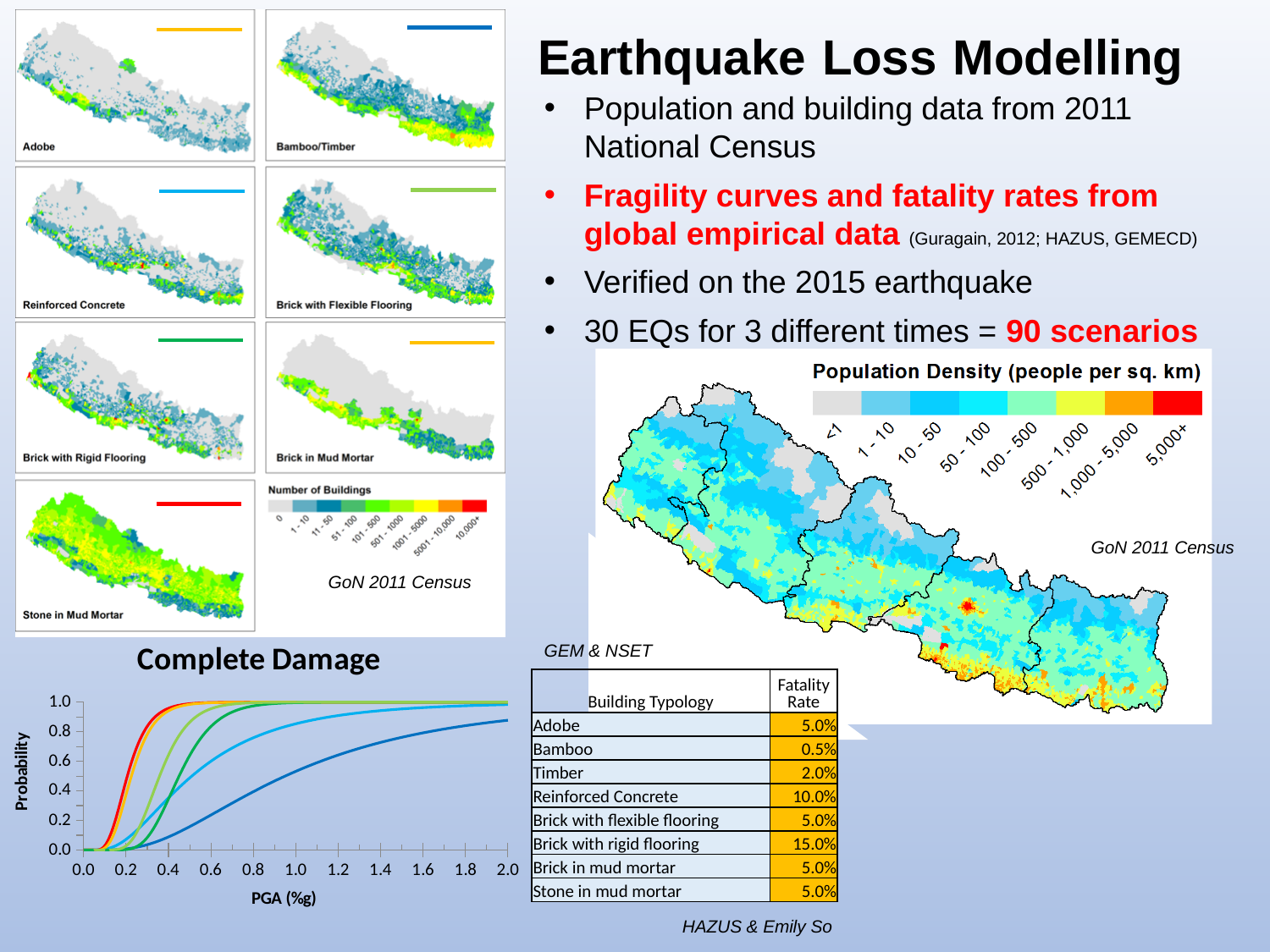
In the 'Complete Damage' chart, is the value of the red curve at PGA 0.4 greater or less than 0.8? greater In the 'Complete Damage' chart, which curve reaches a probability of 1.0 at the lowest PGA? red curve What is the x-axis label of the 'Complete Damage' chart? PGA (%g) What is the title of the line chart at the bottom left of the slide? Complete Damage What kind of chart is the 'Complete Damage' chart? line chart In the 'Complete Damage' chart, do the curves rise or fall as PGA increases? rise What is the maximum value shown on the x axis of the 'Complete Damage' chart? 2.0 In the 'Complete Damage' chart, which curve has the lowest probability at PGA 1.0? dark blue curve In the 'Complete Damage' chart, is the value of the dark blue curve at PGA 0.2 greater or less than 0.2? less In the 'Complete Damage' chart, which curve is higher at PGA 0.6, the red curve or the dark blue curve? red curve In the 'Complete Damage' chart, is the value of the dark blue curve at PGA 1.0 greater or less than 0.8? less